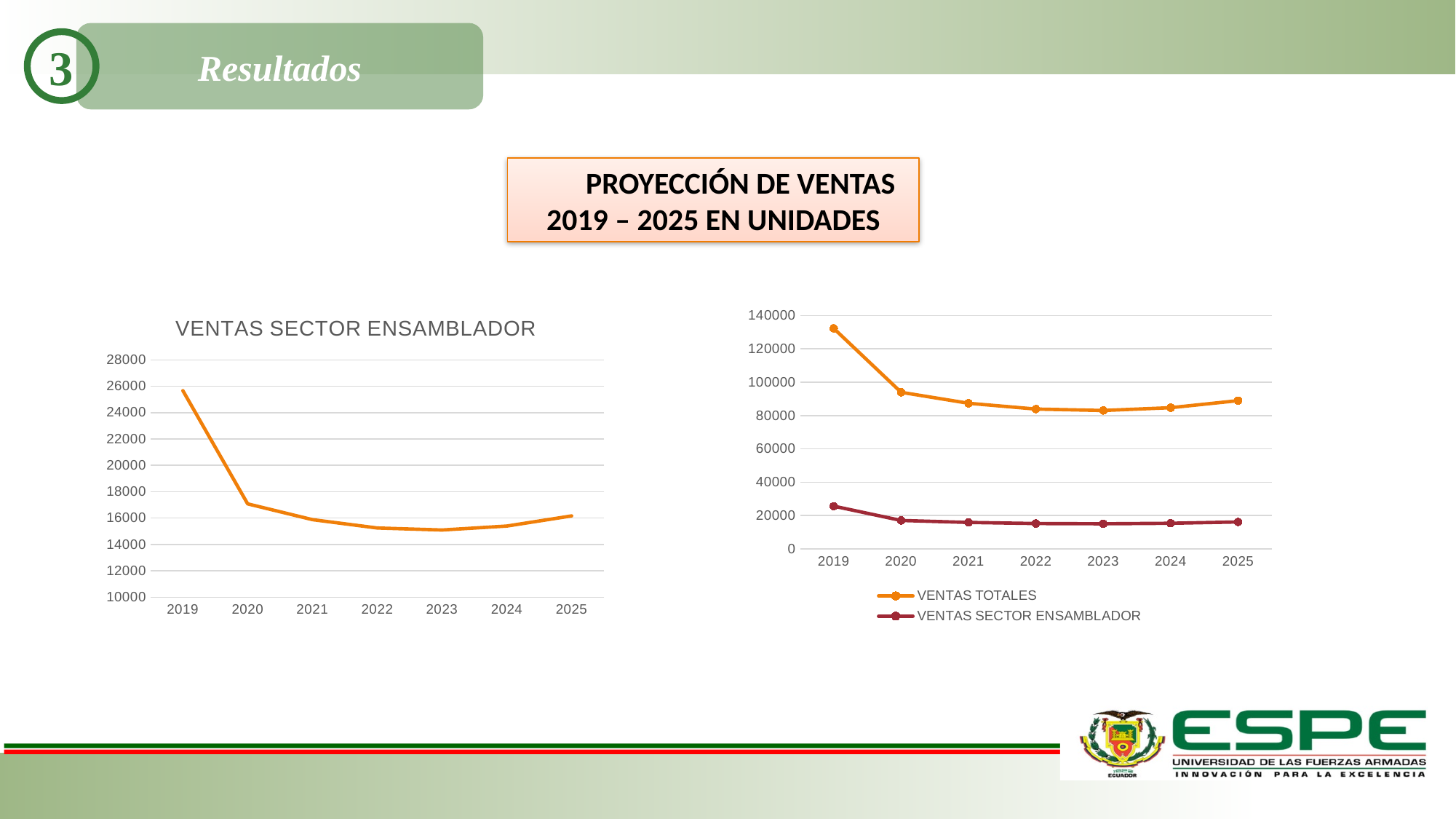
How many series does the legend of the right-hand chart list? 2 In the right-hand chart, is the value for VENTAS TOTALES in 2019 greater or less than 120000? greater How many years are plotted on the x axis of the left chart titled VENTAS SECTOR ENSAMBLADOR? 7 In the right-hand chart, is the value for VENTAS TOTALES in 2023 greater or less than 100000? less In the left chart titled VENTAS SECTOR ENSAMBLADOR, which year has the highest value? 2019 In the right-hand chart, which series has the larger value in 2022, VENTAS TOTALES or VENTAS SECTOR ENSAMBLADOR? VENTAS TOTALES What kind of chart is the chart titled VENTAS SECTOR ENSAMBLADOR on the left? line chart In the left chart titled VENTAS SECTOR ENSAMBLADOR, is the value for 2020 greater or less than 18000? less What are the two series named in the legend of the right-hand chart? VENTAS TOTALES and VENTAS SECTOR ENSAMBLADOR In the right-hand chart, which year has the highest value for VENTAS TOTALES? 2019 In the left chart titled VENTAS SECTOR ENSAMBLADOR, do the values rise or fall from 2019 to 2020? fall